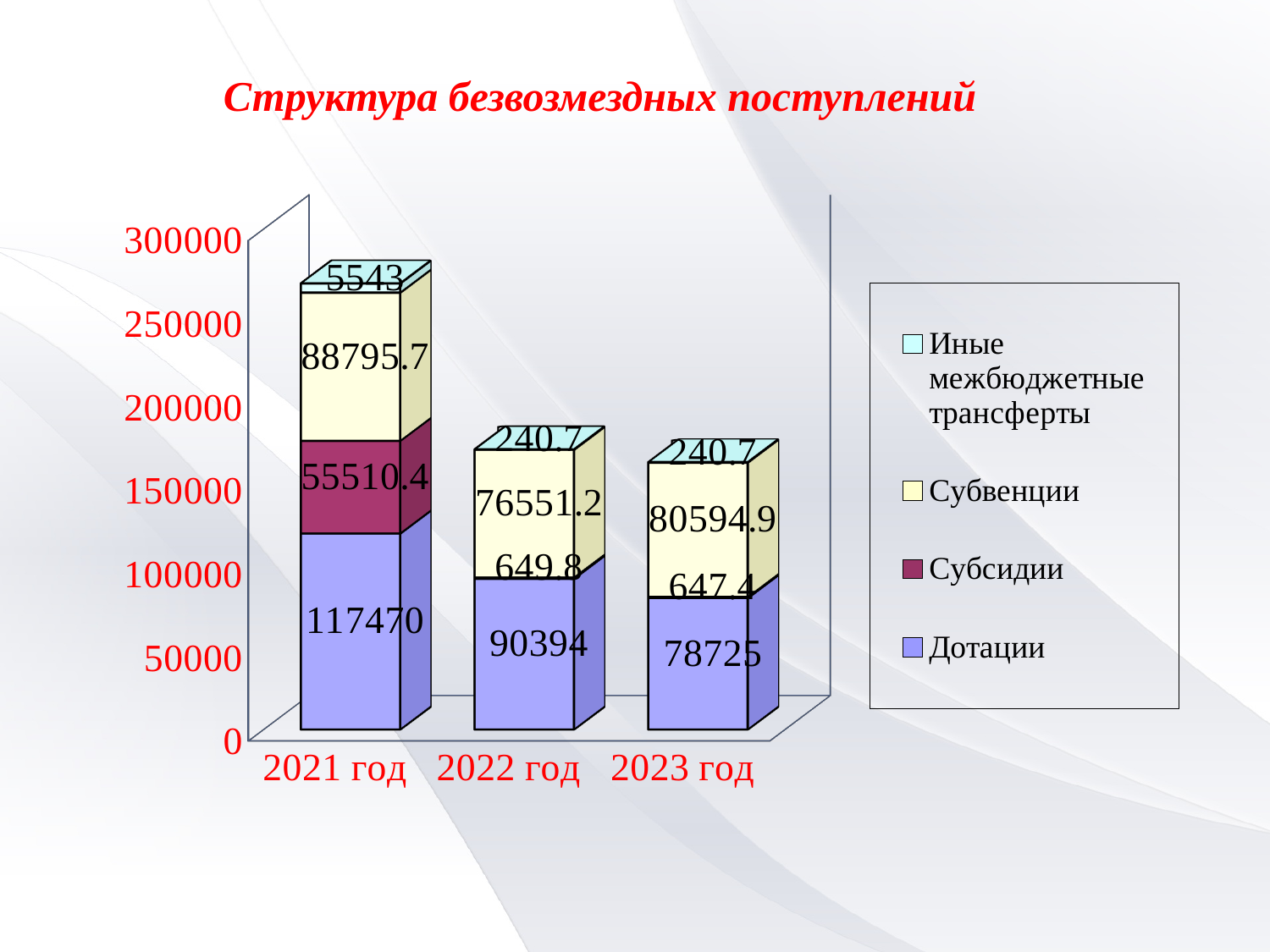
How many series does the legend list? 4 How many years are shown on the x axis? 3 What is the value of Субсидии for 2022 год? 649.8 What is the difference between the Дотации values for 2022 год and 2023 год? 11669 What is the value of Субвенции for 2023 год? 80594.9 What is the value of Дотации for 2021 год? 117470 What kind of chart is shown on the slide? Stacked bar chart What is the value of Иные межбюджетные трансферты for 2021 год? 5543 What is the total of the stacked bar for 2023 год? 160208 Which is larger: Субвенции for 2022 год or Субвенции for 2023 год? Субвенции for 2023 год In which year is the value of Субвенции the lowest? 2022 год In which year is the value of Дотации the highest? 2021 год